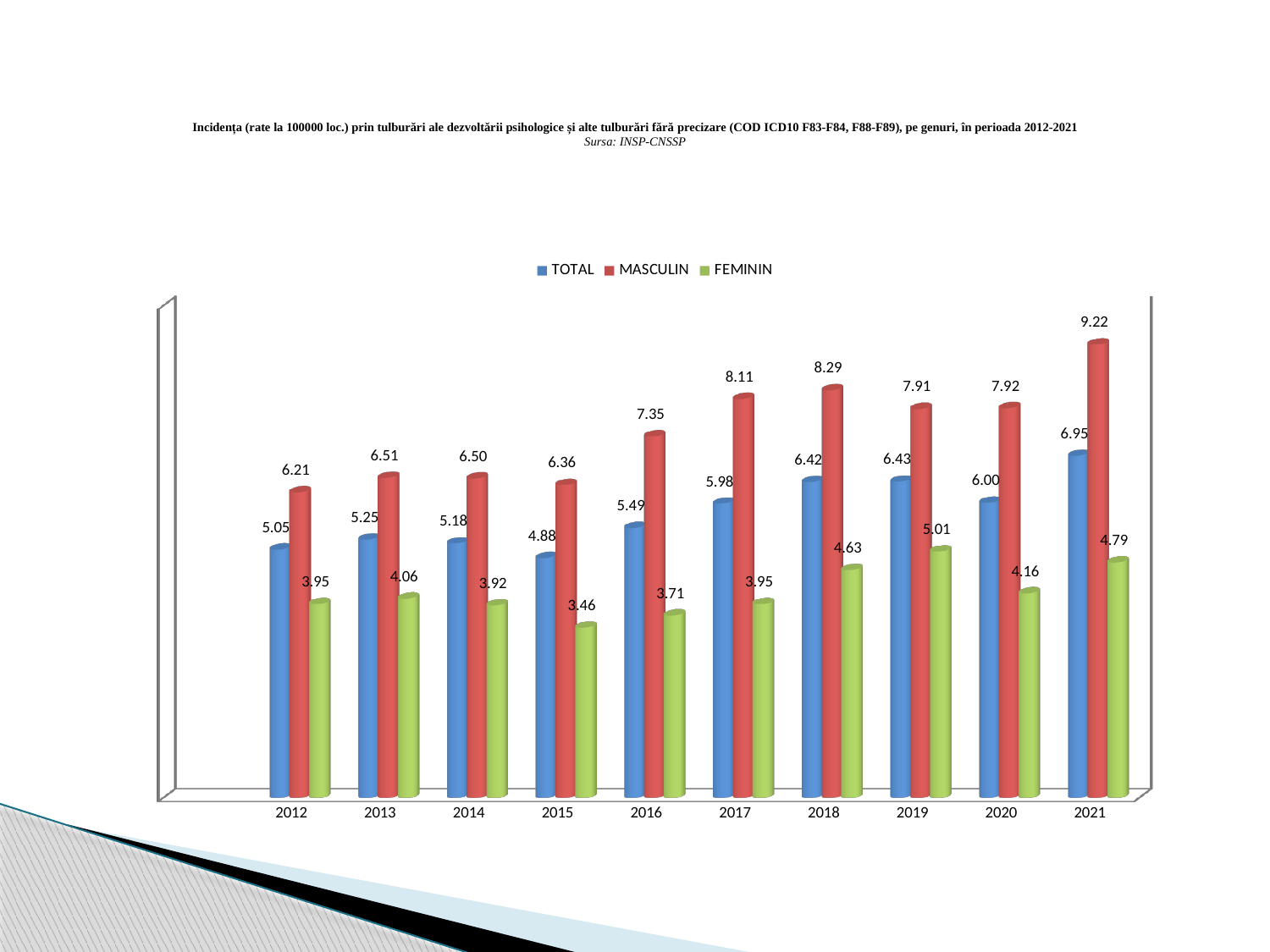
What is the TOTAL value for 2015? 4.88 In which year is the FEMININ value lowest? 2015 What is the difference between the MASCULIN and FEMININ values in 2021? 4.43 Which colour represents the FEMININ series? green Does the MASCULIN series rise or fall from 2015 to 2018? rise How many years are shown on the x axis? 10 In which year is the MASCULIN value highest? 2021 What is the MASCULIN value for 2021? 9.22 What kind of chart is this? bar chart Which is larger, the TOTAL value for 2018 or the TOTAL value for 2019? 2019 What is the FEMININ value for 2019? 5.01 How many series does the legend list? 3